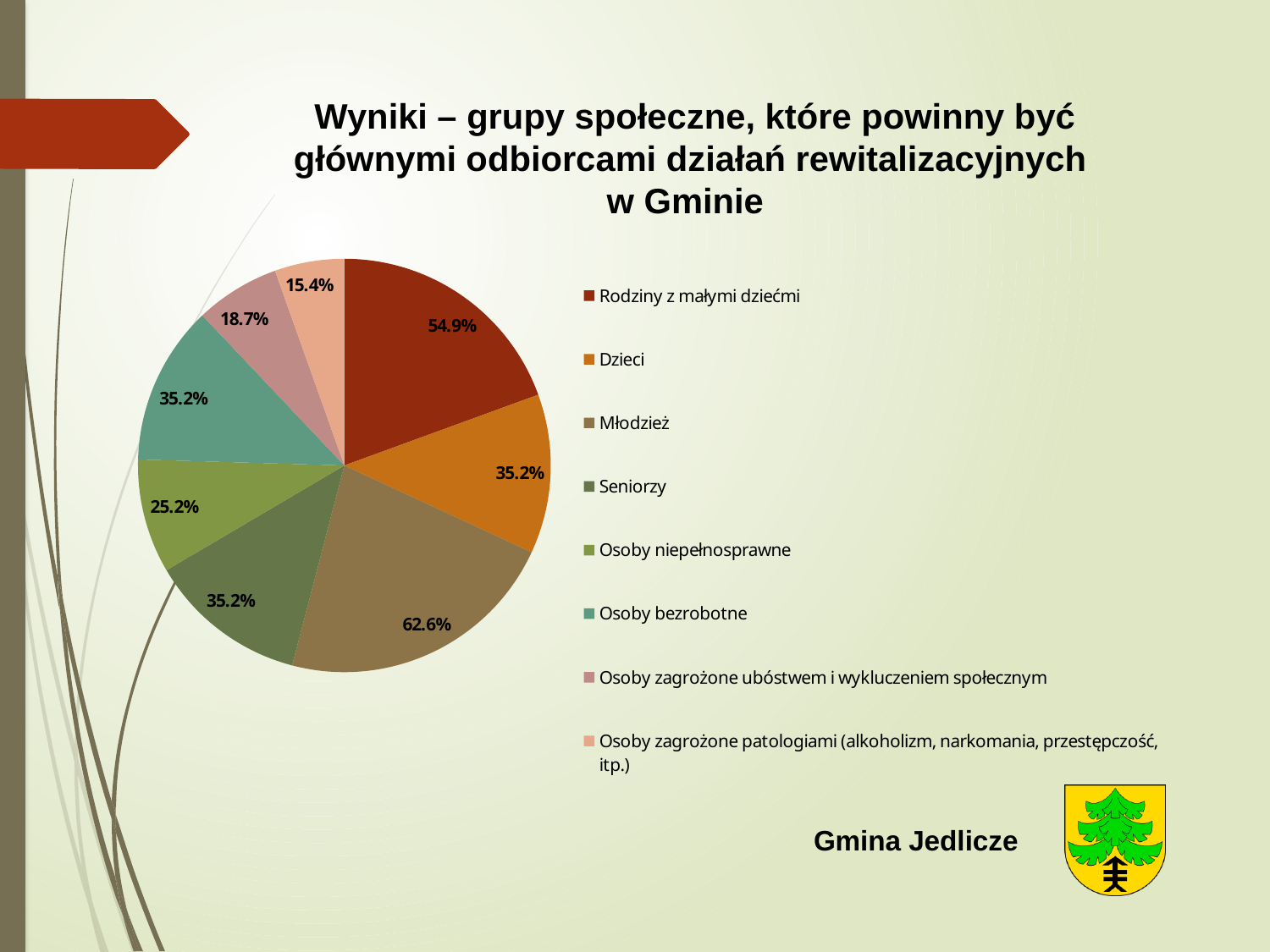
Which legend entry is shown in dark red? Rodziny z małymi dziećmi What value is shown for Osoby niepełnosprawne? 25.2% What value is shown for Rodziny z małymi dziećmi? 54.9% How many groups (slices) does the pie chart show? 8 Which group has the lowest value in the chart? Osoby zagrożone patologiami (alkoholizm, narkomania, przestępczość, itp.) What value is shown for Młodzież? 62.6% Which is larger, the value for Dzieci or the value for Osoby niepełnosprawne? Dzieci What kind of chart is shown on the slide? pie chart What value is shown for Osoby zagrożone ubóstwem i wykluczeniem społecznym? 18.7% What is the difference between the values for Młodzież and Rodziny z małymi dziećmi? 7.7% Which group has the highest value in the chart? Młodzież What value is shown for Osoby zagrożone patologiami (alkoholizm, narkomania, przestępczość, itp.)? 15.4%